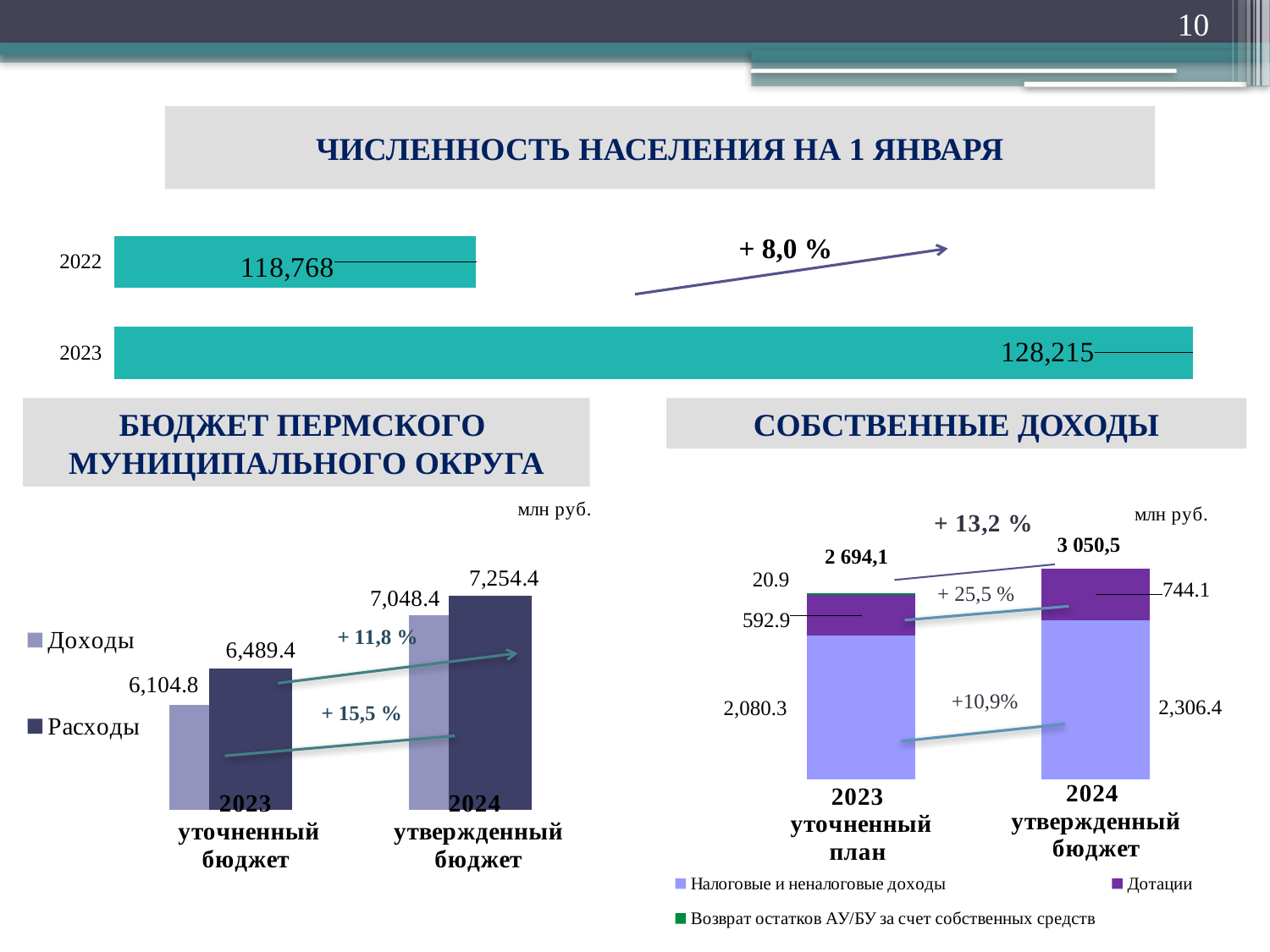
In the chart titled 'ЧИСЛЕННОСТЬ НАСЕЛЕНИЯ НА 1 ЯНВАРЯ', what is the difference between the 2023 and 2022 values? 9,447 In the chart titled 'БЮДЖЕТ ПЕРМСКОГО МУНИЦИПАЛЬНОГО ОКРУГА', by how much do Доходы increase from 2023 to 2024? 943.6 In the chart titled 'СОБСТВЕННЫЕ ДОХОДЫ', what is the value of Налоговые и неналоговые доходы for 2023 уточненный план? 2,080.3 In the chart titled 'БЮДЖЕТ ПЕРМСКОГО МУНИЦИПАЛЬНОГО ОКРУГА', what is the value of Доходы for 2023 уточненный бюджет? 6,104.8 In the chart titled 'СОБСТВЕННЫЕ ДОХОДЫ', what is the value of Дотации for 2024 утвержденный бюджет? 744.1 What kind of chart is the one titled 'ЧИСЛЕННОСТЬ НАСЕЛЕНИЯ НА 1 ЯНВАРЯ'? bar chart In the chart titled 'БЮДЖЕТ ПЕРМСКОГО МУНИЦИПАЛЬНОГО ОКРУГА', how many series does the legend list? 2 In the chart titled 'ЧИСЛЕННОСТЬ НАСЕЛЕНИЯ НА 1 ЯНВАРЯ', what is the value for 2023? 128,215 In the chart titled 'БЮДЖЕТ ПЕРМСКОГО МУНИЦИПАЛЬНОГО ОКРУГА', which is larger for 2024: Доходы or Расходы? Расходы In the chart titled 'СОБСТВЕННЫЕ ДОХОДЫ', how many series does the legend list? 3 In the chart titled 'БЮДЖЕТ ПЕРМСКОГО МУНИЦИПАЛЬНОГО ОКРУГА', what is the value of Расходы for 2024 утвержденный бюджет? 7,254.4 In the chart titled 'СОБСТВЕННЫЕ ДОХОДЫ', what is the total of the stacked bar for 2023 уточненный план? 2 694,1